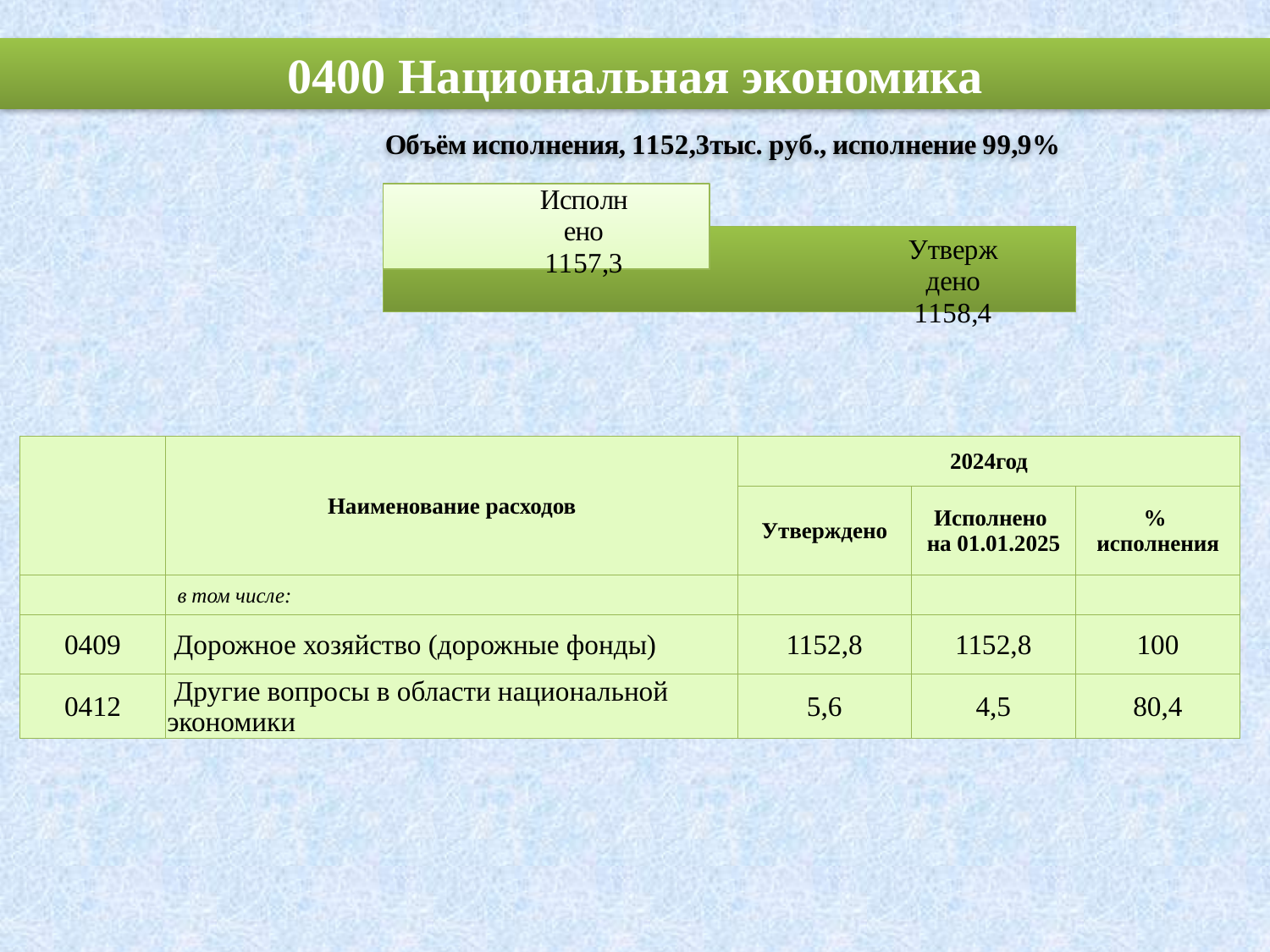
What kind of chart is shown on the slide? bar chart What is the value shown for Утверждено in the chart? 1158,4 Which category in the chart has the lower value? Исполнено How many bars are plotted in the chart? 2 Is the value for Утверждено larger or smaller than the value for Исполнено in the chart? larger Which bar in the chart is drawn in the darker green colour? Утверждено Which category in the chart has the higher value? Утверждено What is the difference between the Утверждено and Исполнено values in the chart? 1,1 What is the value shown for Исполнено in the chart? 1157,3 Which bar in the chart is drawn in the lighter green colour? Исполнено